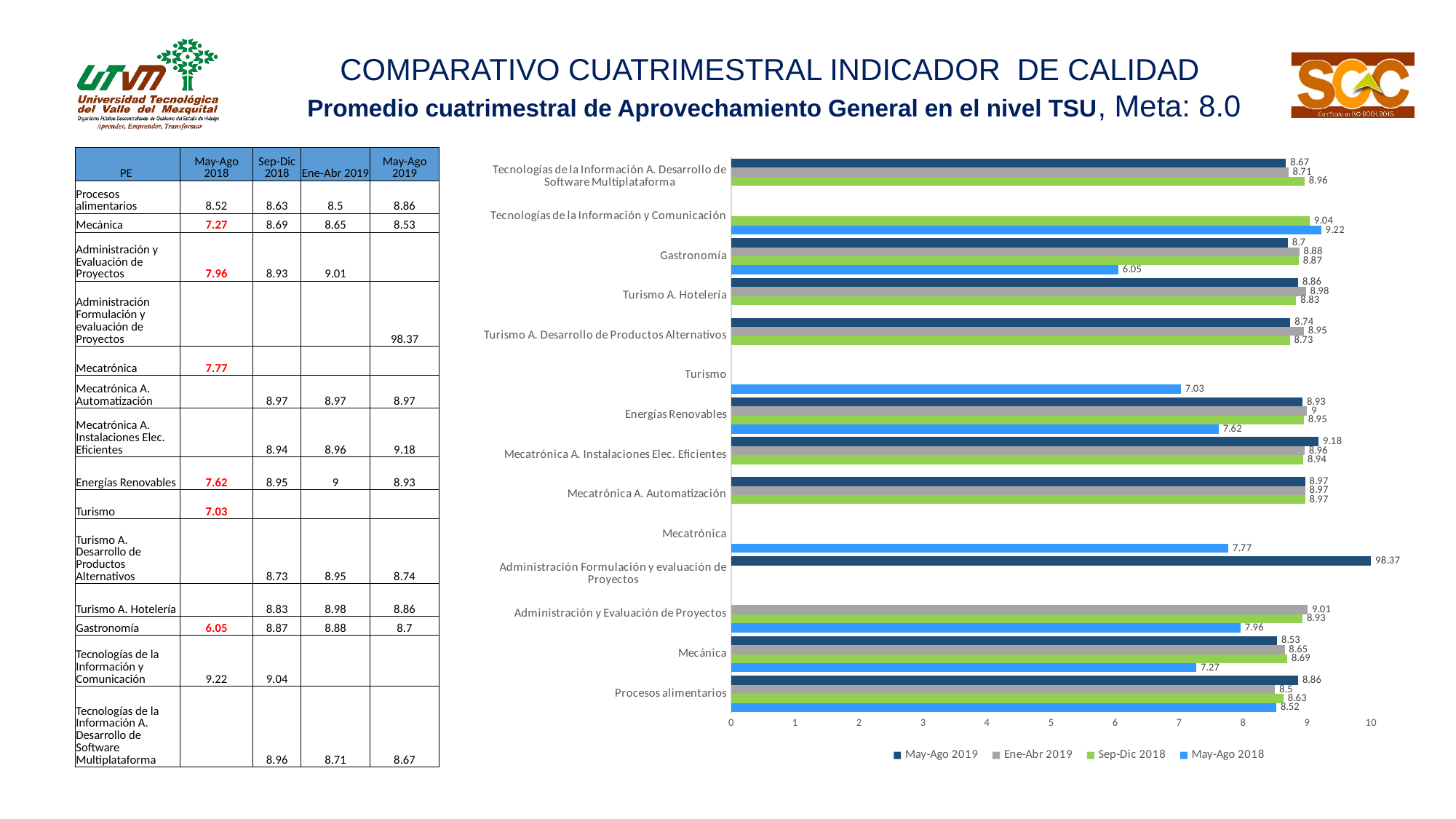
What is the difference between the Sep-Dic 2018 and May-Ago 2018 values for Mecánica? 1.42 Is the May-Ago 2018 value for Mecatrónica greater or less than 8? less How many series does the legend list? 4 What is the May-Ago 2019 value for Mecatrónica A. Instalaciones Elec. Eficientes? 9.18 What is the May-Ago 2019 value for Administración Formulación y evaluación de Proyectos? 98.37 What kind of chart is shown on the slide? bar chart For Energías Renovables, which is larger: the May-Ago 2019 value or the Sep-Dic 2018 value? Sep-Dic 2018 What is the May-Ago 2018 value for Gastronomía? 6.05 Which category has the lowest May-Ago 2018 value? Gastronomía Which category has the highest Sep-Dic 2018 value? Tecnologías de la Información y Comunicación What is the May-Ago 2018 value for Turismo? 7.03 How many categories are shown on the chart's vertical axis? 14